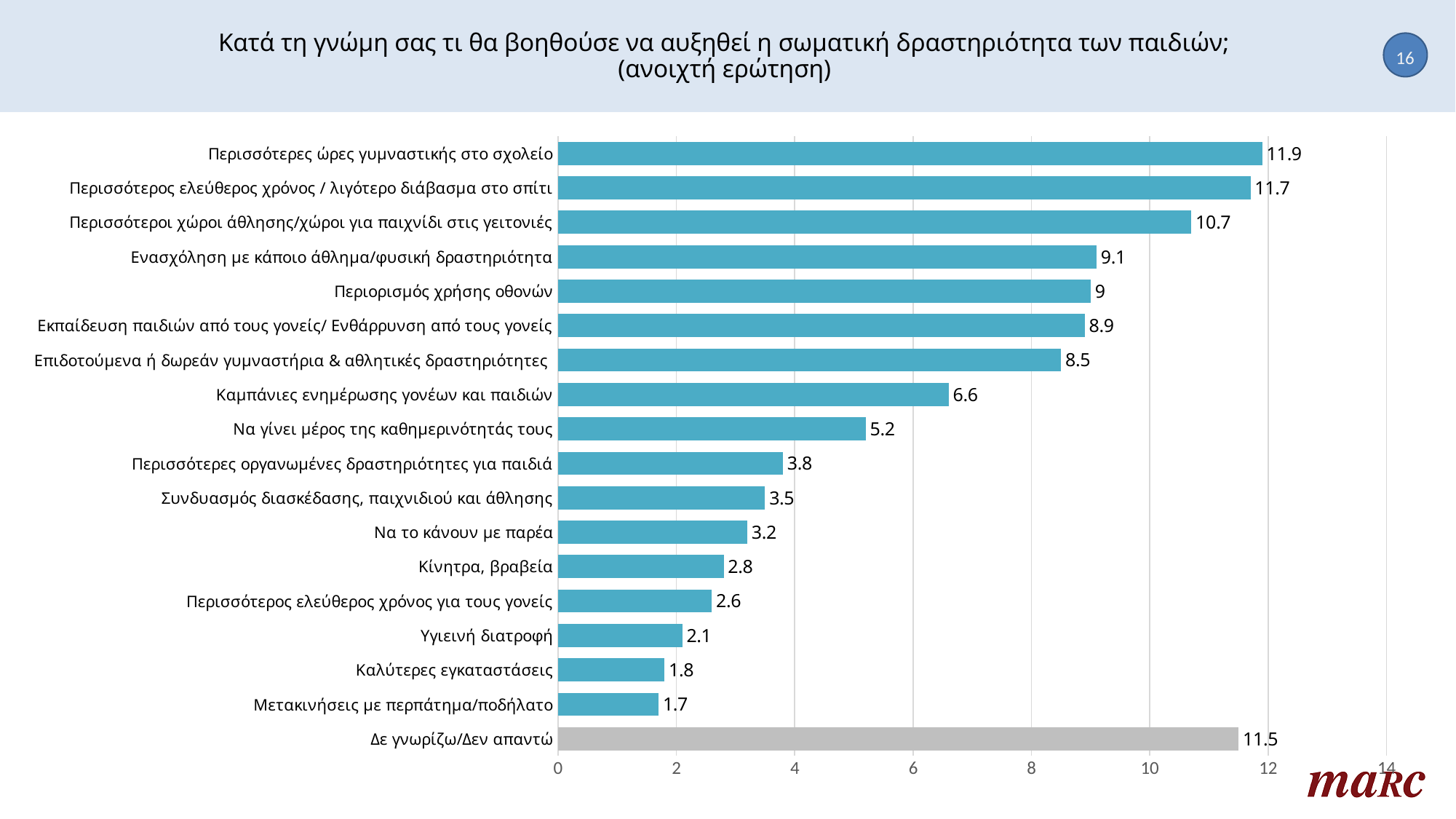
Which bar is shown in a different colour (grey) from the others? Δε γνωρίζω/Δεν απαντώ Which category has the lowest value? Μετακινήσεις με περπάτημα/ποδήλατο What is the value for "Δε γνωρίζω/Δεν απαντώ"? 11.5 What is the value for "Περισσότερες ώρες γυμναστικής στο σχολείο"? 11.9 Which category has the highest value? Περισσότερες ώρες γυμναστικής στο σχολείο What is the value for "Περιορισμός χρήσης οθονών"? 9 Is the value for "Επιδοτούμενα ή δωρεάν γυμναστήρια & αθλητικές δραστηριότητες" greater or less than 8? greater Which is larger: the value for "Κίνητρα, βραβεία" or the value for "Να το κάνουν με παρέα"? Να το κάνουν με παρέα What is the value for "Υγιεινή διατροφή"? 2.1 How many categories are shown in the chart? 18 What kind of chart is shown on the slide? bar chart What is the difference between the values for "Περισσότεροι χώροι άθλησης/χώροι για παιχνίδι στις γειτονιές" and "Καμπάνιες ενημέρωσης γονέων και παιδιών"? 4.1